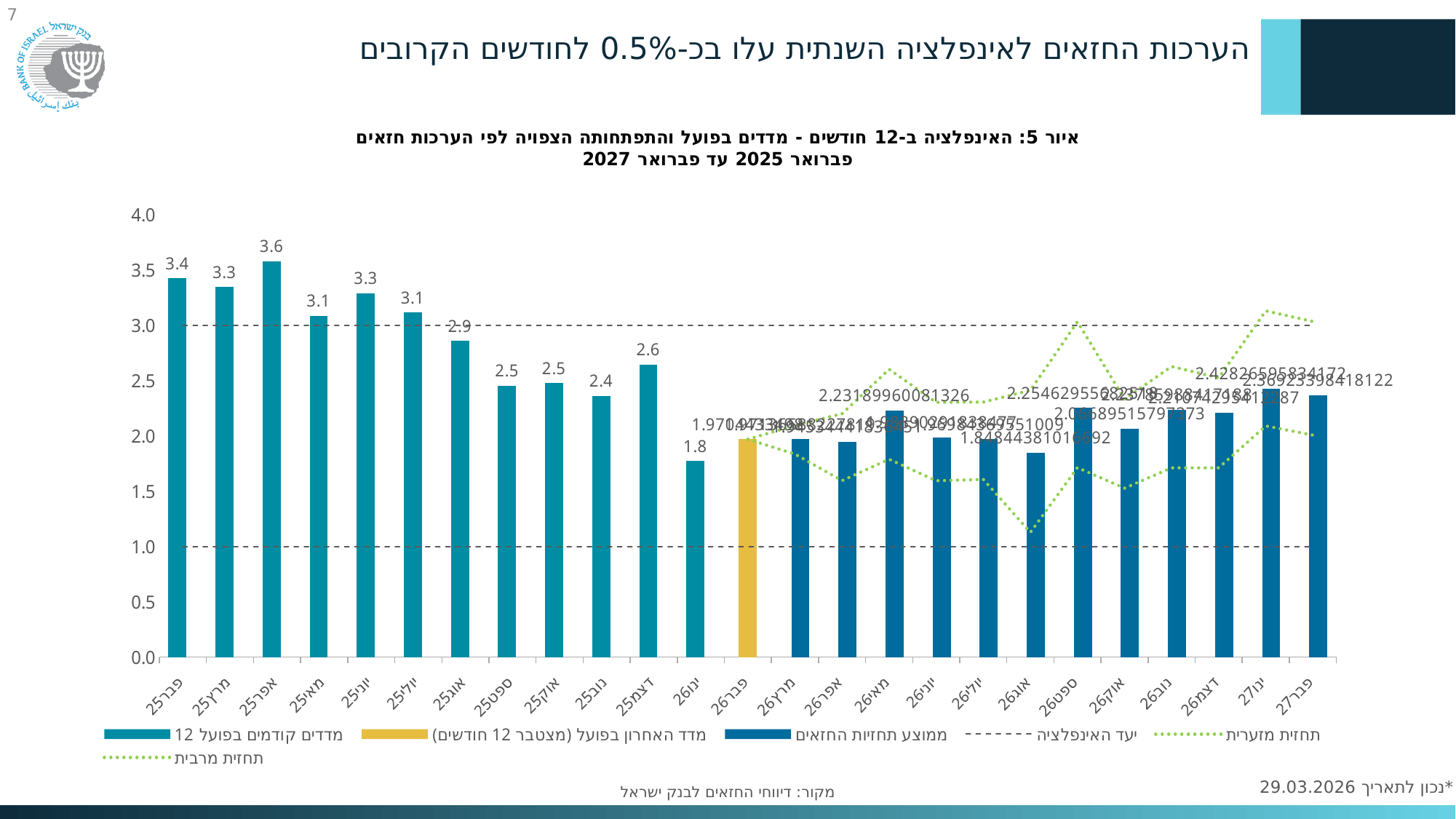
Do the actual values fall or rise from פבר25 (Feb 25) to ינו26 (Jan 26)? fall Which month has the highest bar in the chart? אפר25 (Apr 25) What is the value for אוג25 (Aug 25)? 2.9 How many months are shown on the x axis? 25 What is the value for פבר25 (Feb 25)? 3.4 How many entries does the legend list? 6 Which is larger, the value for יוני25 (Jun 25) or יולי25 (Jul 25)? יוני25 (Jun 25) What is the value for אפר25 (Apr 25)? 3.6 Among the 2025 months, which has the lowest value? נוב25 (Nov 25) What is the difference between the values for פבר25 (Feb 25) and ינו26 (Jan 26)? 1.6 Is the value for אוג26 (Aug 26) greater or less than 2.0? less What is the value for ינו26 (Jan 26)? 1.8